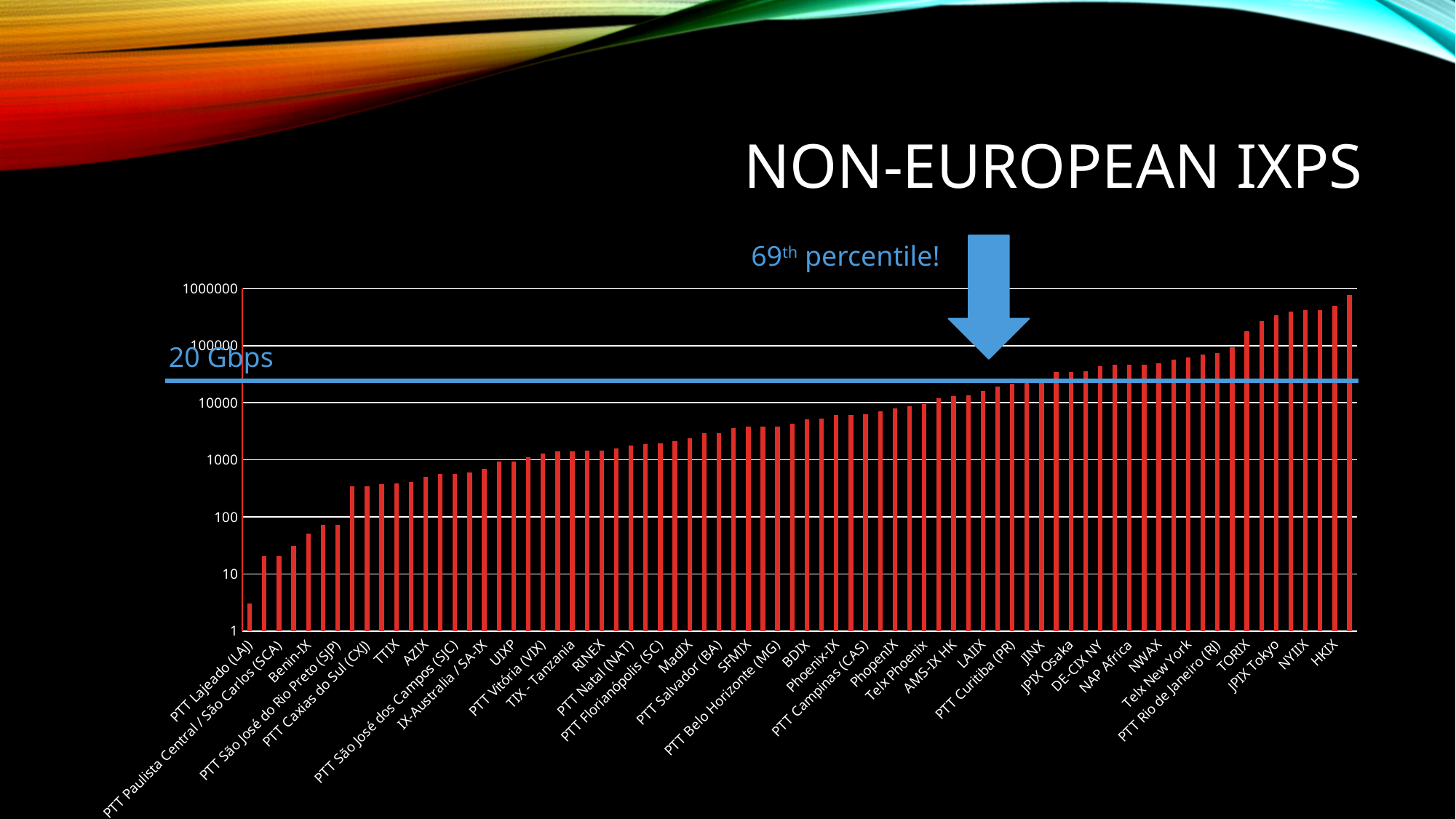
Is the value for Benin-IX greater or less than 100? less Is the value for TORIX greater or less than 100000? greater Is the value for TTIX greater or less than 1000? less Which IXP has the lowest value in the chart? PTT Lajeado (LAJ) Do the bar values rise or fall from left to right along the x axis? rise What kind of chart is shown on the slide? bar chart Which has the larger value, TORIX or TTIX? TORIX What value is labelled on the horizontal blue line drawn across the chart? 20 Gbps